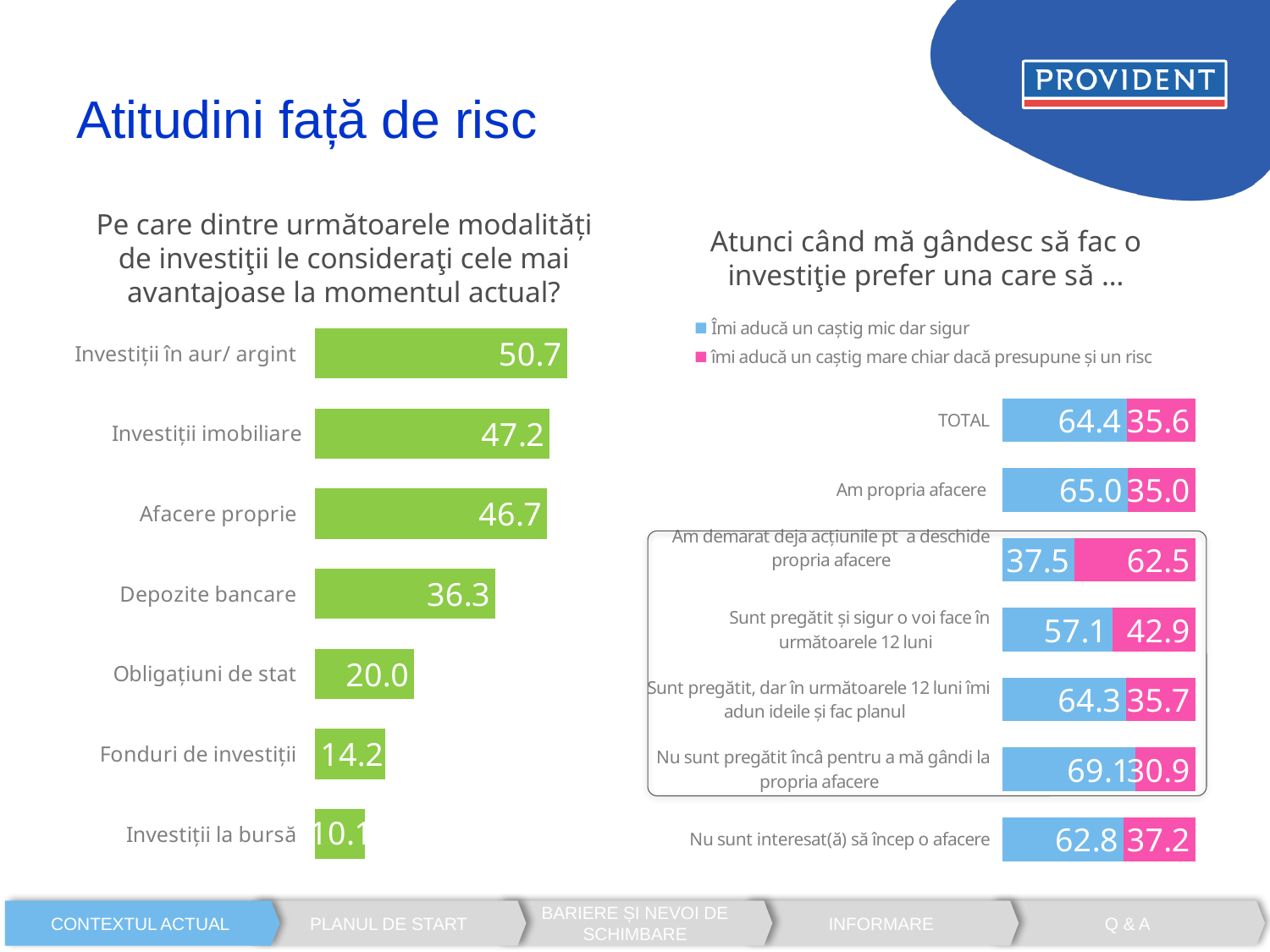
In the right chart (Atunci când mă gândesc să fac o investiţie...), which category has the highest value for 'Îmi aducă un caștig mic dar sigur'? Nu sunt pregătit încâ pentru a mă gândi la propria afacere In the right chart (Atunci când mă gândesc să fac o investiţie...), what is the value of 'Îmi aducă un caștig mic dar sigur' for TOTAL? 64.4 In the left chart (Pe care dintre următoarele modalități de investiţii...), how many categories are shown? 7 What kind of chart is the left chart (Pe care dintre următoarele modalități de investiţii...)? Bar chart In the left chart (Pe care dintre următoarele modalități de investiţii...), what is the difference between Investiții imobiliare and Obligațiuni de stat? 27.2 In the left chart (Pe care dintre următoarele modalități de investiţii...), which category has the highest value? Investiții în aur/ argint In the left chart (Pe care dintre următoarele modalități de investiţii...), which category has the lowest value? Investiții la bursă In the left chart (Pe care dintre următoarele modalități de investiţii...), what is the value for Depozite bancare? 36.3 In the right chart (Atunci când mă gândesc să fac o investiţie...), how many series does the legend list? 2 In the right chart (Atunci când mă gândesc să fac o investiţie...), is the 'Îmi aducă un caștig mic dar sigur' value larger for 'Am propria afacere' or for 'Sunt pregătit și sigur o voi face în următoarele 12 luni'? Am propria afacere In the left chart (Pe care dintre următoarele modalități de investiţii...), what is the value for Investiții în aur/ argint? 50.7 In the right chart (Atunci când mă gândesc să fac o investiţie...), what is the value of 'îmi aducă un caștig mare chiar dacă presupune și un risc' for 'Am demarat deja acțiunile pt a deschide propria afacere'? 62.5